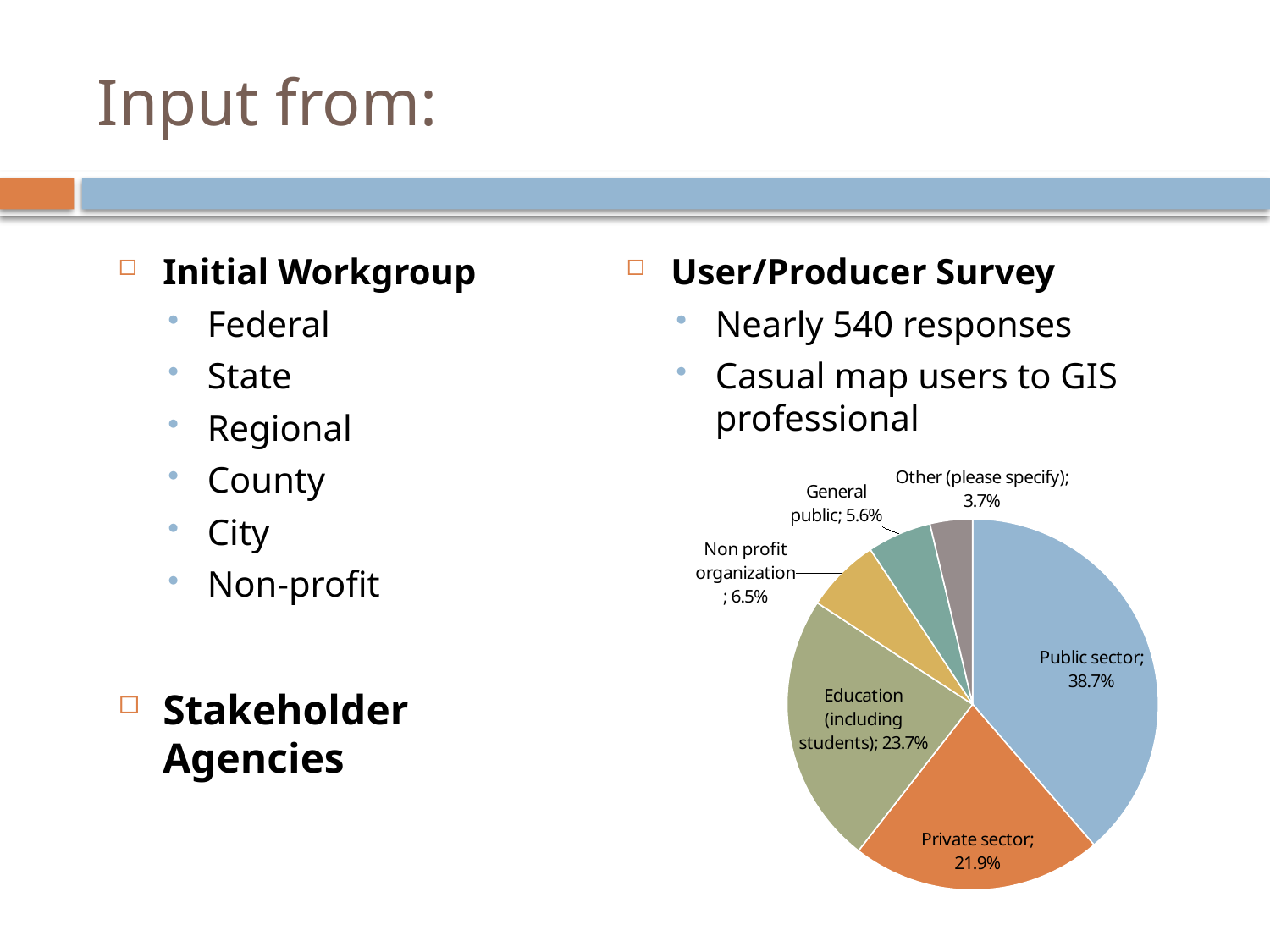
How many slices does the pie chart have? 6 What is the value for Education (including students)? 23.7% What is the value for General public? 5.6% What is the difference between the Public sector and Private sector shares? 16.8% What is the value for Non profit organization? 6.5% Which category has the largest slice of the pie? Public sector What is the value for Private sector? 21.9% Which category has the smallest slice of the pie? Other (please specify) What colour is the Public sector slice? blue Which is larger, Education (including students) or Private sector? Education (including students) What share of the pie does Public sector have? 38.7% What kind of chart is shown on the slide? pie chart